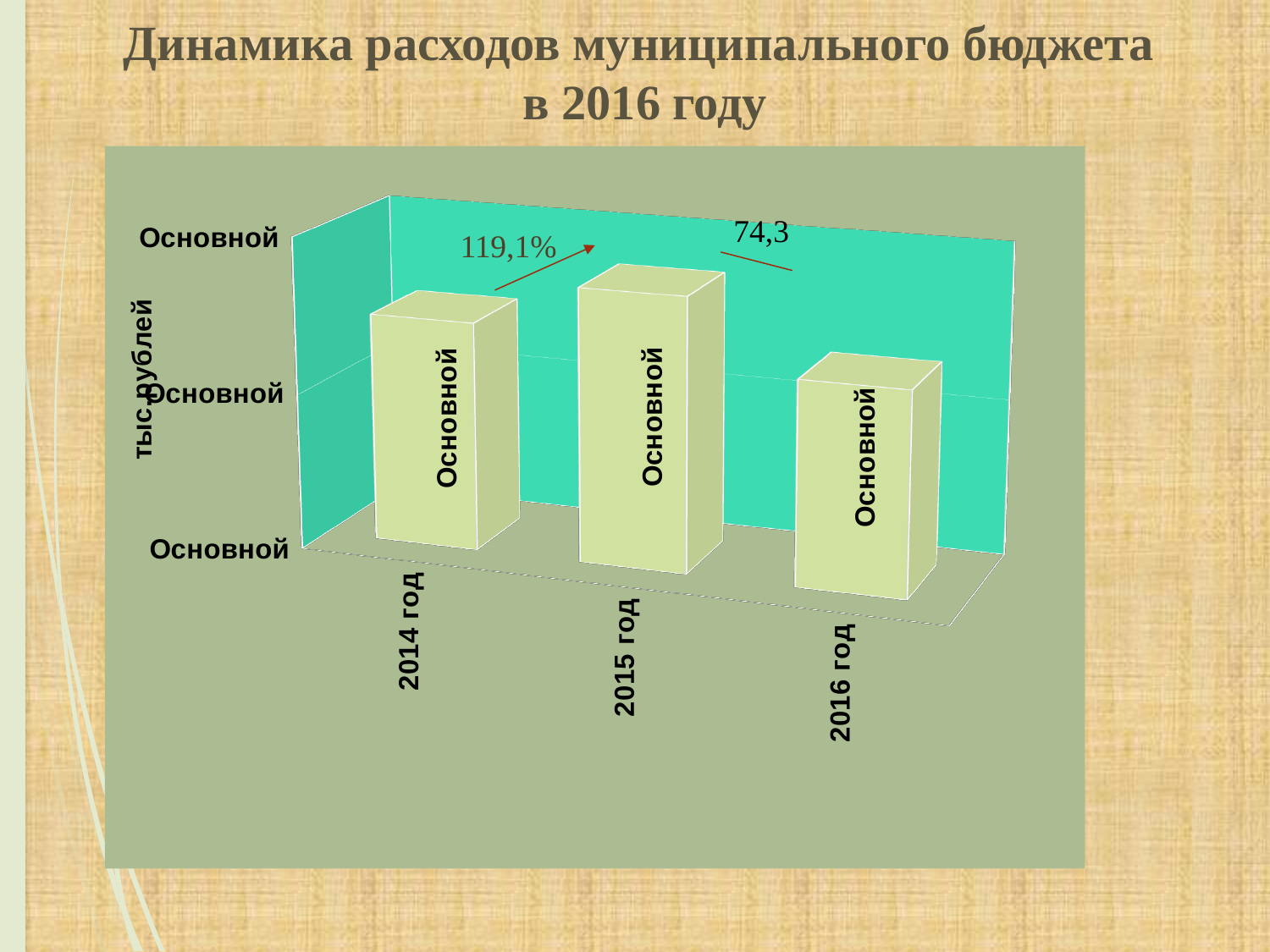
Which bar is shorter, 2015 год or 2016 год? 2016 год Which bar is taller, 2014 год or 2015 год? 2015 год Which year has the highest bar in the chart? 2015 год Do the bars rise or fall from 2015 год to 2016 год? fall What is the title of the slide containing the chart? Динамика расходов муниципального бюджета в 2016 году What is the label on the vertical axis of the chart? тыс.рублей Do the bars rise or fall from 2014 год to 2015 год? rise How many bars (years) are plotted in the chart? 3 Which year has the lowest bar in the chart? 2016 год What kind of chart is shown on the slide? bar chart Which bar is taller, 2014 год or 2016 год? 2014 год